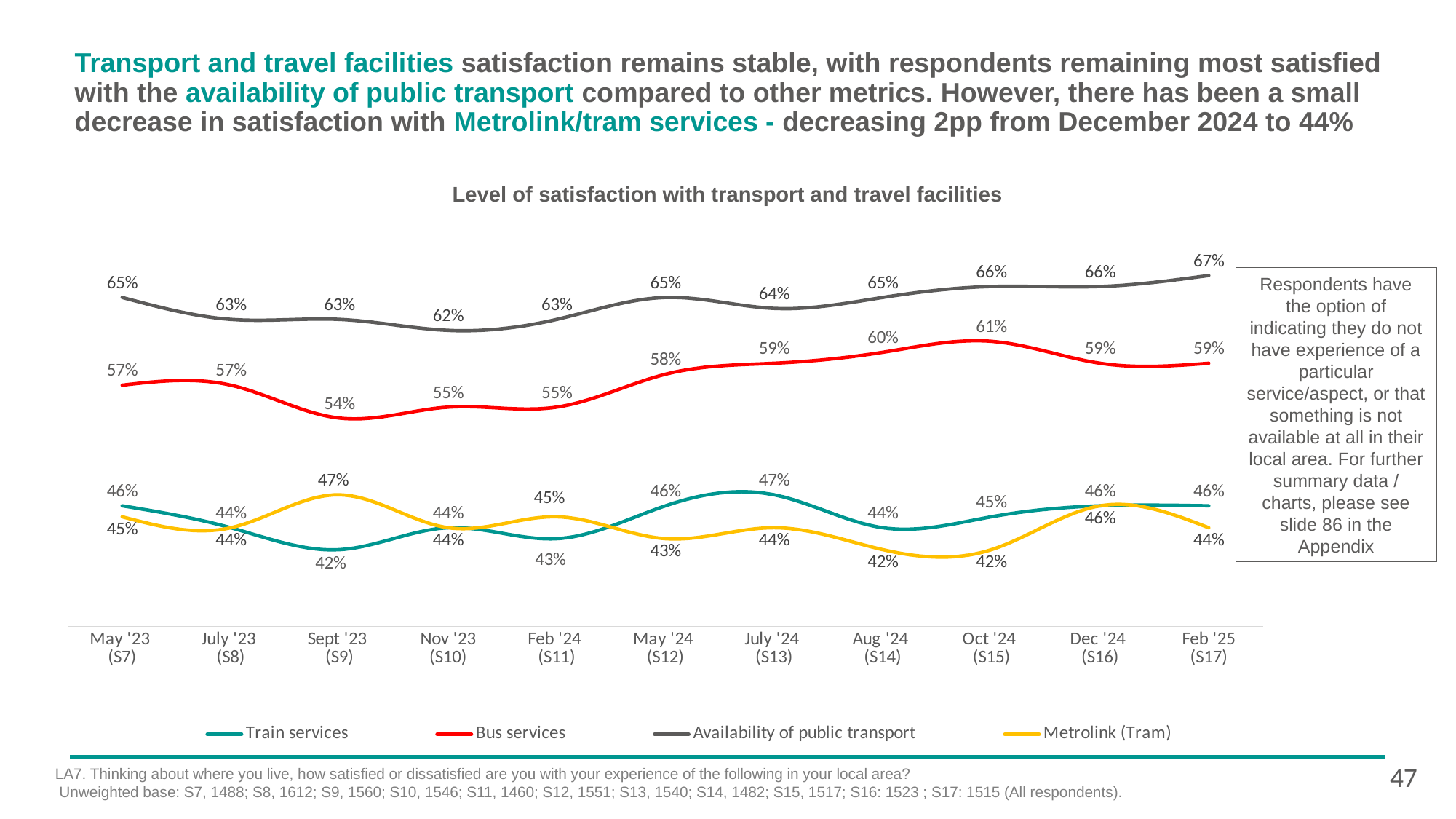
Which is larger in Sept '23 (S9): Train services or Metrolink (Tram)? Metrolink (Tram) What is the value for Bus services in Sept '23 (S9)? 54% At which time point is Bus services highest? Oct '24 (S15) At which time point is Availability of public transport lowest? Nov '23 (S10) How many series does the legend list? 4 What is the value for Availability of public transport in Feb '25 (S17)? 67% How many time points are plotted along the x axis? 11 What is the value for Train services in July '24 (S13)? 47% What is the difference between Availability of public transport and Bus services in Feb '25 (S17)? 8% What type of chart is shown on the slide? Line chart What is the title of the chart? Level of satisfaction with transport and travel facilities What is the value for Metrolink (Tram) in Feb '25 (S17)? 44%